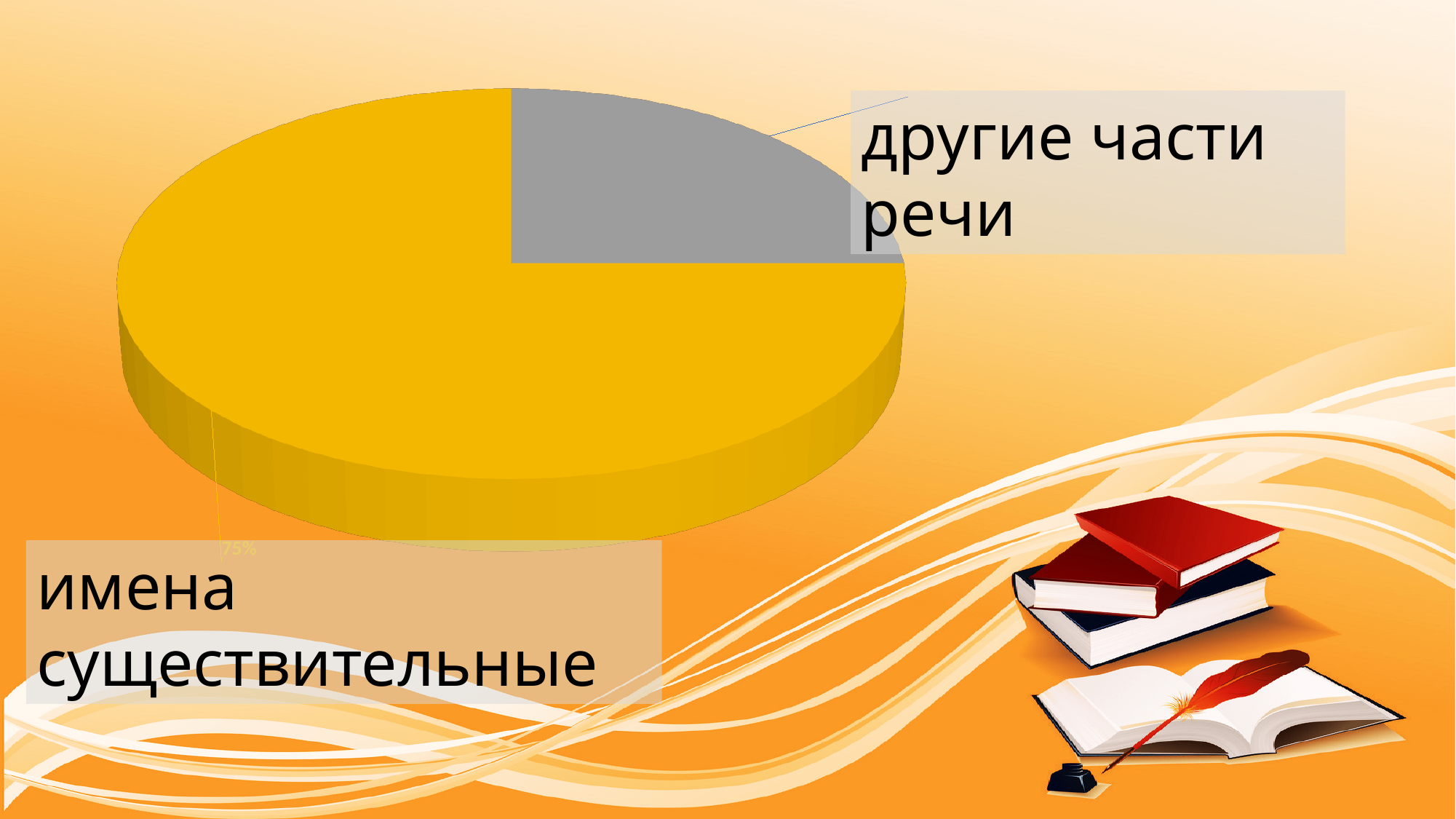
Which slice of the pie chart is the largest? имена существительные Which slice of the pie chart is the smallest? другие части речи What percentage is shown for the slice "имена существительные"? 75% What kind of chart is shown on the slide? pie chart How many slices does the pie chart have? 2 Which is larger in the pie chart: "имена существительные" or "другие части речи"? имена существительные What colour is the slice for "имена существительные"? yellow What colour is the slice for "другие части речи"? gray